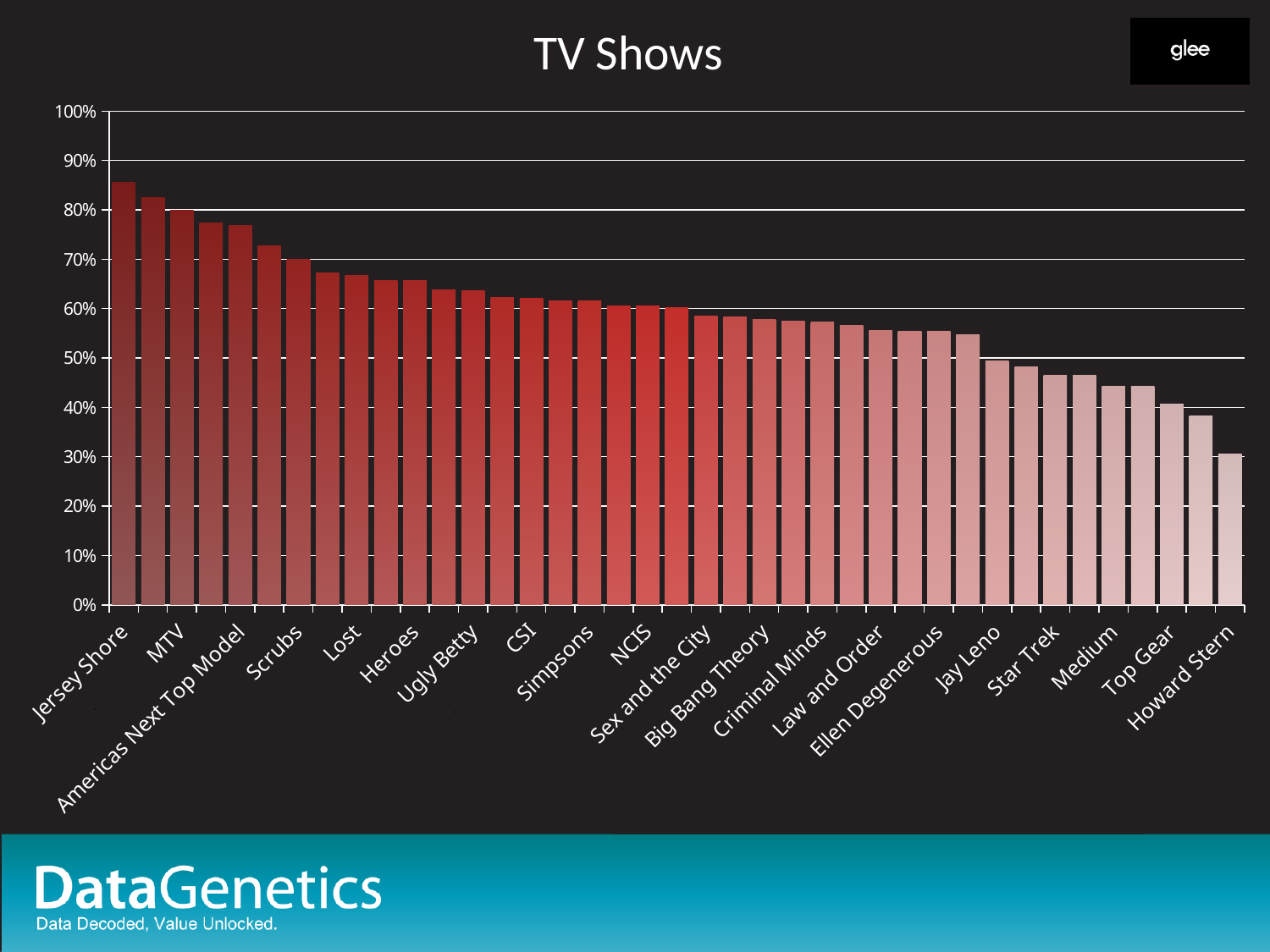
What is the title of the chart? TV Shows Do the values rise or fall moving from left to right along the x axis? fall Which TV show has the lowest value in the chart? Howard Stern Is the value for Jersey Shore greater or less than 80%? greater What kind of chart is shown on the slide? bar chart Which TV show has the highest value in the chart? Jersey Shore Which has the larger value, Scrubs or Medium? Scrubs Is the value for Lost greater or less than 70%? less Which has the larger value, Star Trek or Heroes? Heroes Is the value for Medium greater or less than 50%? less